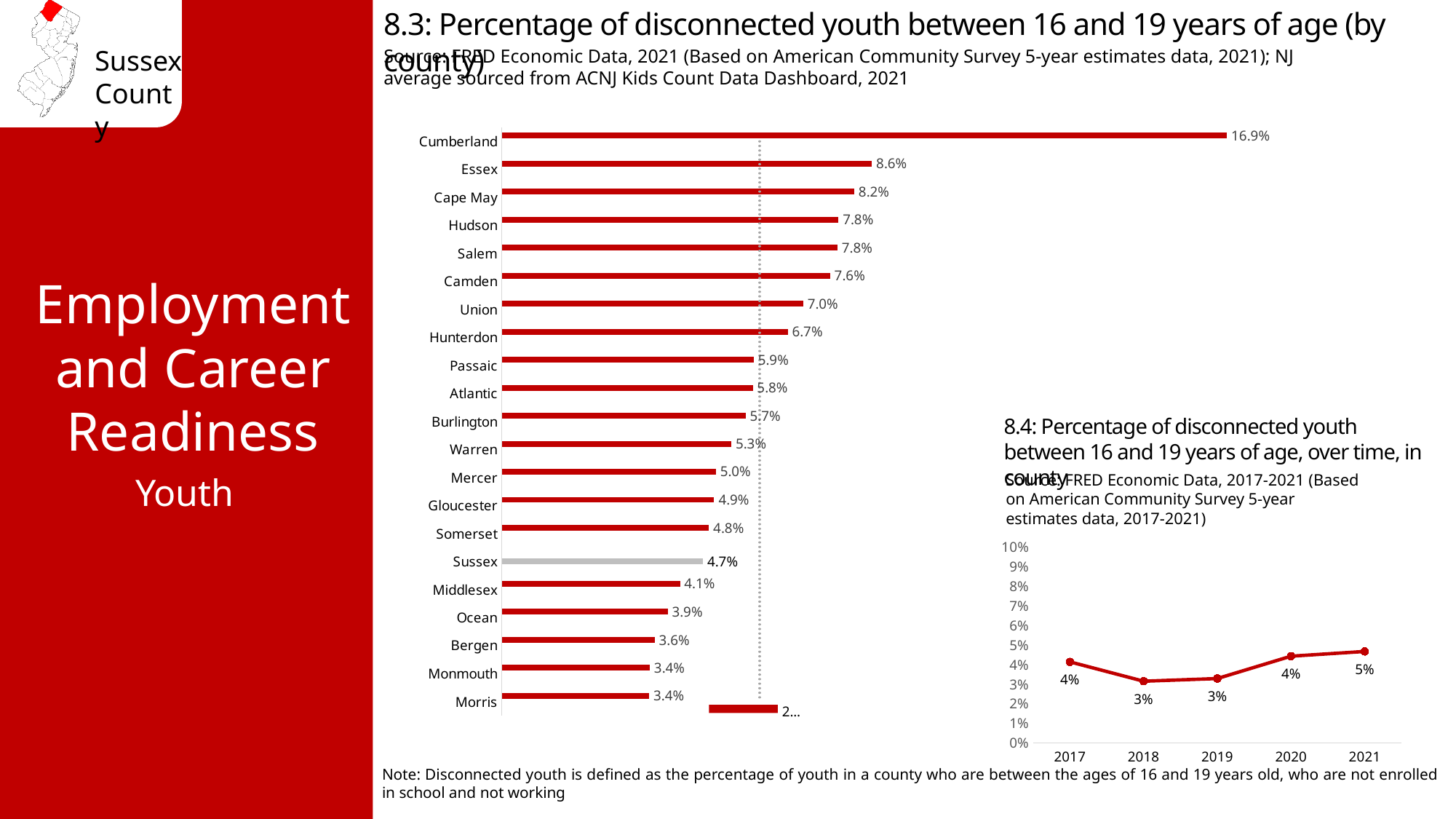
In chart 8.3 (percentage of disconnected youth by county), what is the difference between Sussex and Morris? 1.3% In chart 8.3 (percentage of disconnected youth by county), what is the value for Sussex? 4.7% In chart 8.4 (percentage of disconnected youth over time), what is the value for 2021? 5% In chart 8.3 (percentage of disconnected youth by county), how many counties are shown? 21 What kind of chart is chart 8.3 (percentage of disconnected youth by county)? Bar chart In chart 8.4 (percentage of disconnected youth over time), how many years are plotted? 5 In chart 8.3 (percentage of disconnected youth by county), which county has the highest value? Cumberland In chart 8.4 (percentage of disconnected youth over time), which year has the highest value? 2021 In chart 8.3 (percentage of disconnected youth by county), what is the value for Essex? 8.6% In chart 8.4 (percentage of disconnected youth over time), do the values rise or fall from 2019 to 2021? Rise In chart 8.3 (percentage of disconnected youth by county), what is the difference between Cumberland and Essex? 8.3% In chart 8.3 (percentage of disconnected youth by county), which is larger, the value for Warren or the value for Mercer? Warren